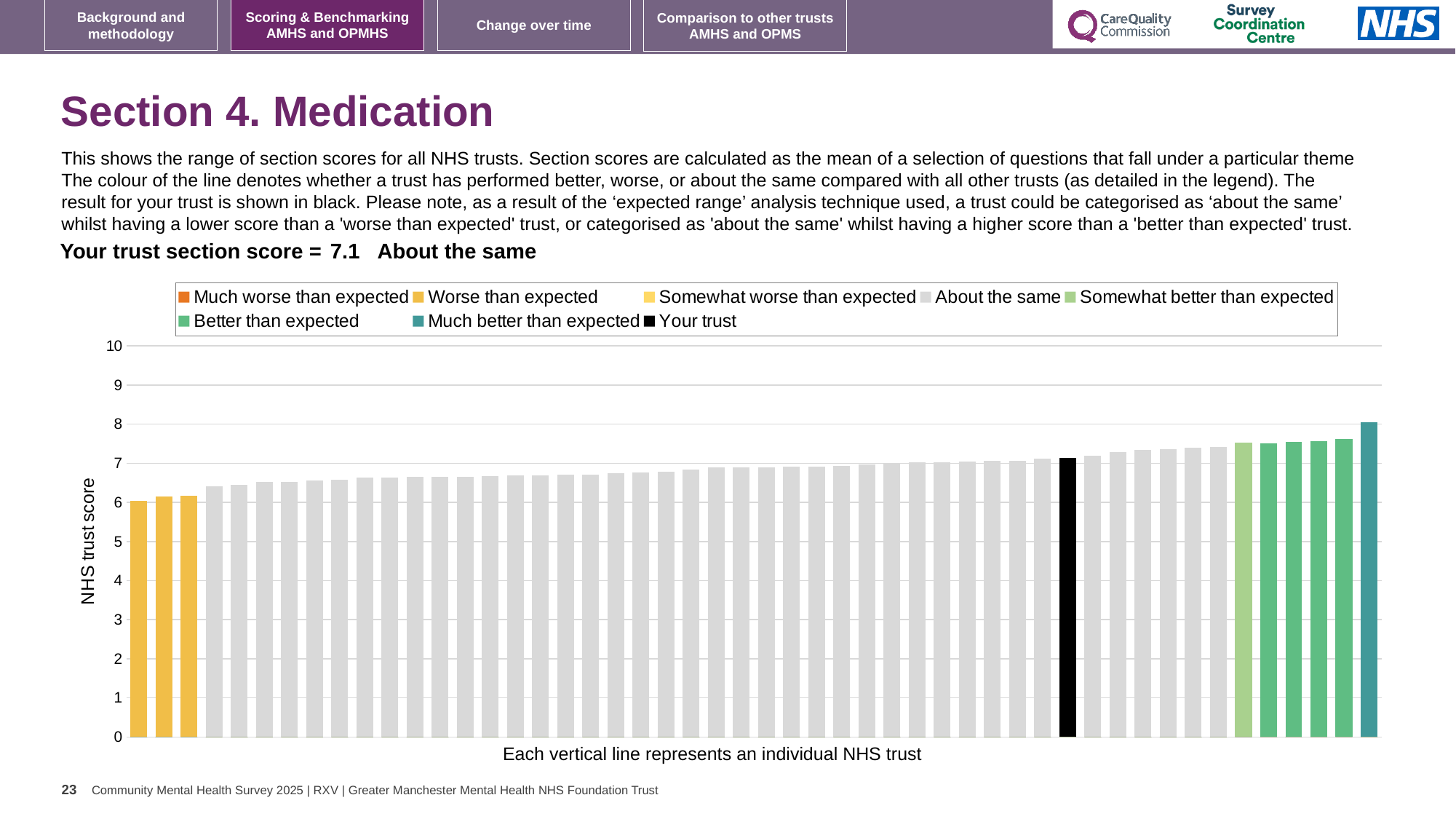
Is the value of the tallest bar (the 'Much better than expected' trust) greater or less than 9? less Is the value of the black 'Your trust' bar greater or less than 8? less Is the value of the leftmost bar greater or less than 7? less How many entries does the chart legend list? 8 What is the section score for your trust (the black bar)? 7.1 What colour does the legend use for 'Your trust'? black Do the bar values rise or fall from left to right along the x axis? rise What kind of chart is shown on the slide? bar chart Which is taller: the black 'Your trust' bar or the leftmost yellow bar? the black 'Your trust' bar Which legend category does the tallest bar belong to? Much better than expected What is the label on the vertical axis of the chart? NHS trust score How many bars are coloured as 'Worse than expected'? 3